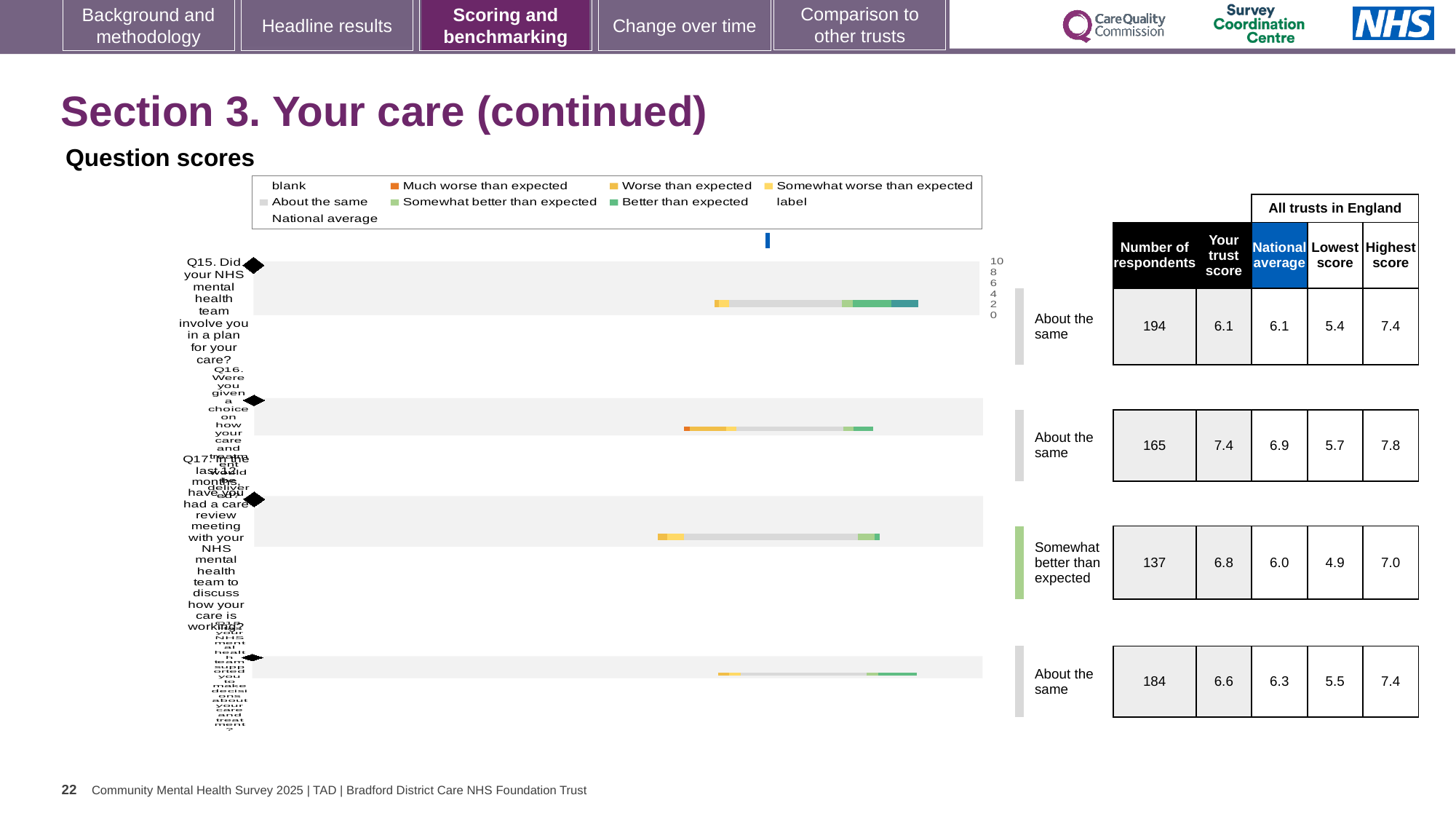
Which question row has the fewest respondents in the table? Q17 (137) What benchmark category is shown for Q17 (care review meeting)? Somewhat better than expected In the table beside the chart, what is the 'Your trust score' for Q15 (involving you in a plan for your care)? 6.1 For Q17, which is larger: the trust score or the national average? the trust score (6.8) What is the difference between the trust score and the national average for Q16? 0.5 How many respondents are listed for Q17 (care review meeting)? 137 What is the highest score among all trusts in England for Q15? 7.4 How many question bars are plotted in the question scores chart? 4 In the table beside the chart, what is the national average for Q16? 6.9 Which question row has the highest 'Your trust score' in the table? Q16 (7.4) What is the lowest score among all trusts in England for Q16? 5.7 What kind of chart is used to show the question scores on this slide? bar chart